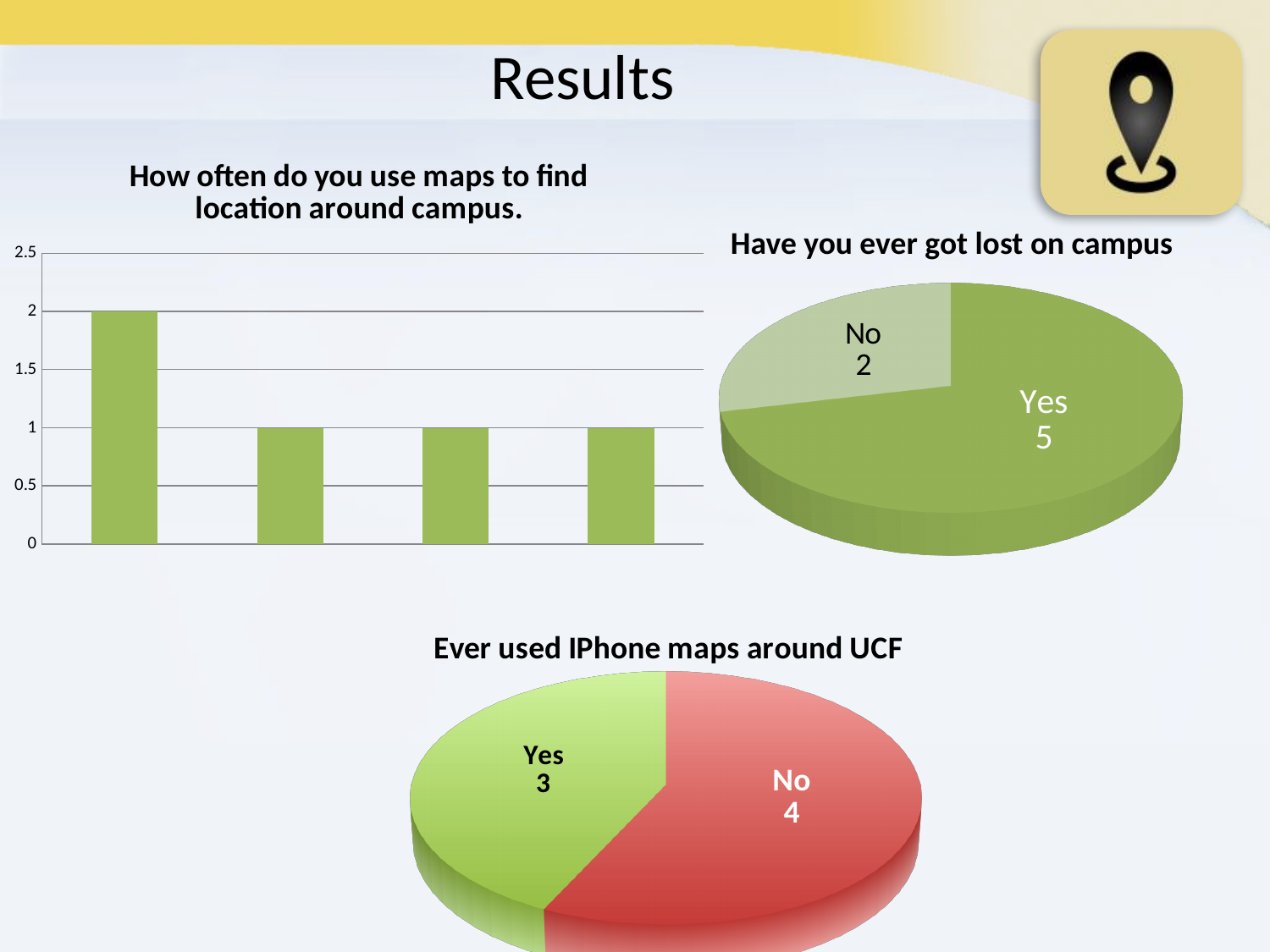
In the 'How often do you use maps to find location around campus.' chart, what is the value of the lowest bars? 1 In the 'Have you ever got lost on campus' chart, how many respondents answered No? 2 How many bars are plotted in the 'How often do you use maps to find location around campus.' chart? 4 What kind of chart is the 'How often do you use maps to find location around campus.' chart? bar chart In the 'Have you ever got lost on campus' chart, what is the difference between the Yes and No counts? 3 In the 'Have you ever got lost on campus' chart, which slice is larger, Yes or No? Yes In the 'Ever used IPhone maps around UCF' chart, how many respondents answered No? 4 What kind of chart is the 'Ever used IPhone maps around UCF' chart? pie chart In the 'Have you ever got lost on campus' chart, how many respondents answered Yes? 5 In the 'How often do you use maps to find location around campus.' chart, what is the highest value shown on the vertical axis? 2.5 In the 'Ever used IPhone maps around UCF' chart, how many respondents answered Yes? 3 In the 'How often do you use maps to find location around campus.' chart, what is the value of the tallest bar? 2